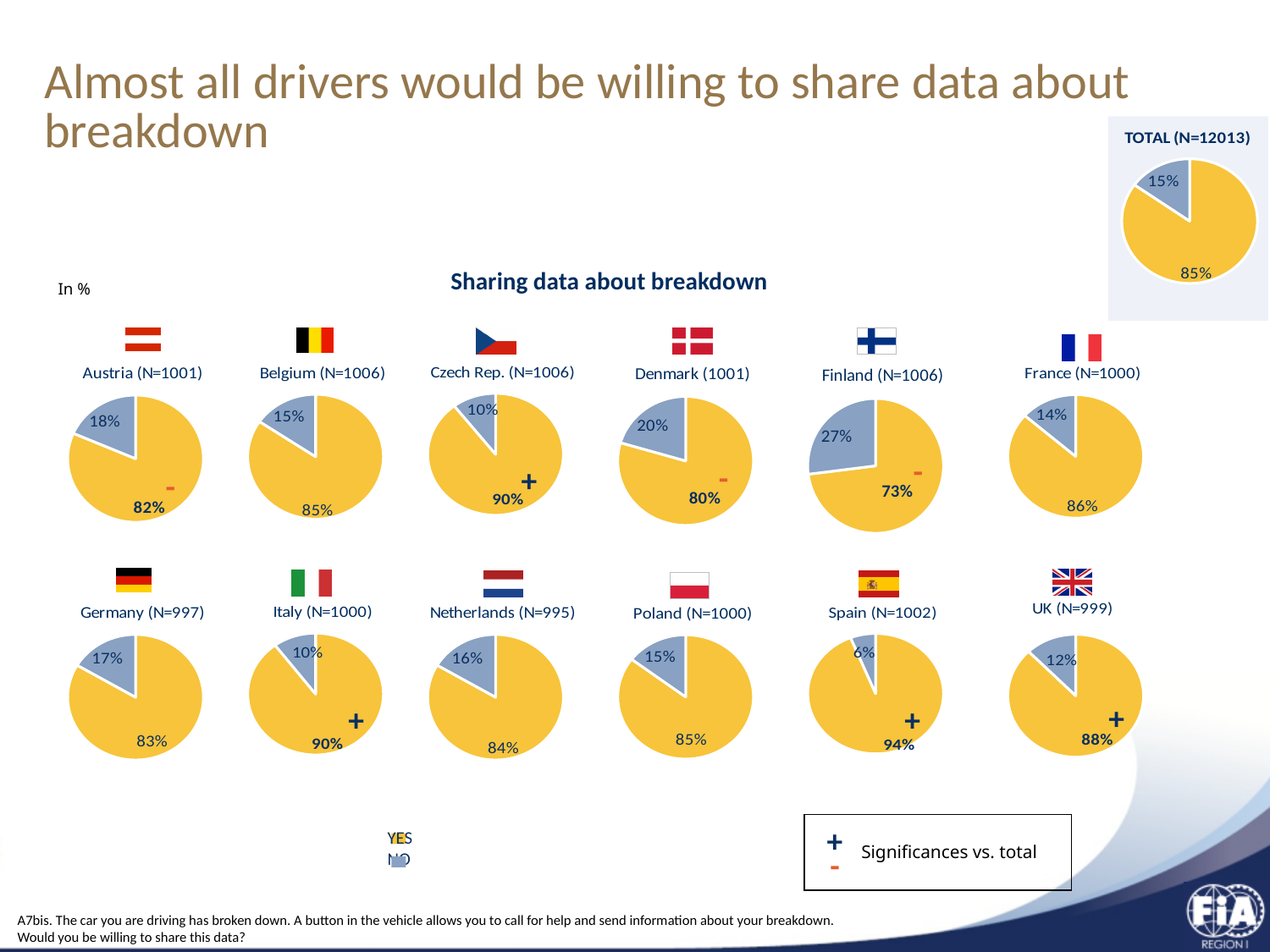
Which is larger: the NO share in the Denmark (1001) pie chart or the NO share in the Austria (N=1001) pie chart? Denmark In the TOTAL (N=12013) pie chart, what percentage of drivers answered YES? 85% Among the country pie charts, which country has the lowest YES share? Finland In the Finland (N=1006) pie chart, what percentage of drivers answered YES? 73% In the Spain (N=1002) pie chart, what percentage of drivers answered NO? 6% According to the legend, which colour represents the YES answer in the pie charts? Yellow What type of chart is used to show the sharing data about breakdown results for each country? Pie chart What is the difference between the YES share in the Spain pie chart and the YES share in the Finland pie chart? 21 percentage points Among the country pie charts, which country has the highest YES share? Spain In the Czech Rep. (N=1006) pie chart, what is the YES share? 90% How many country pie charts are shown on the slide (excluding the TOTAL chart)? 12 In the UK (N=999) pie chart, what is the NO share? 12%